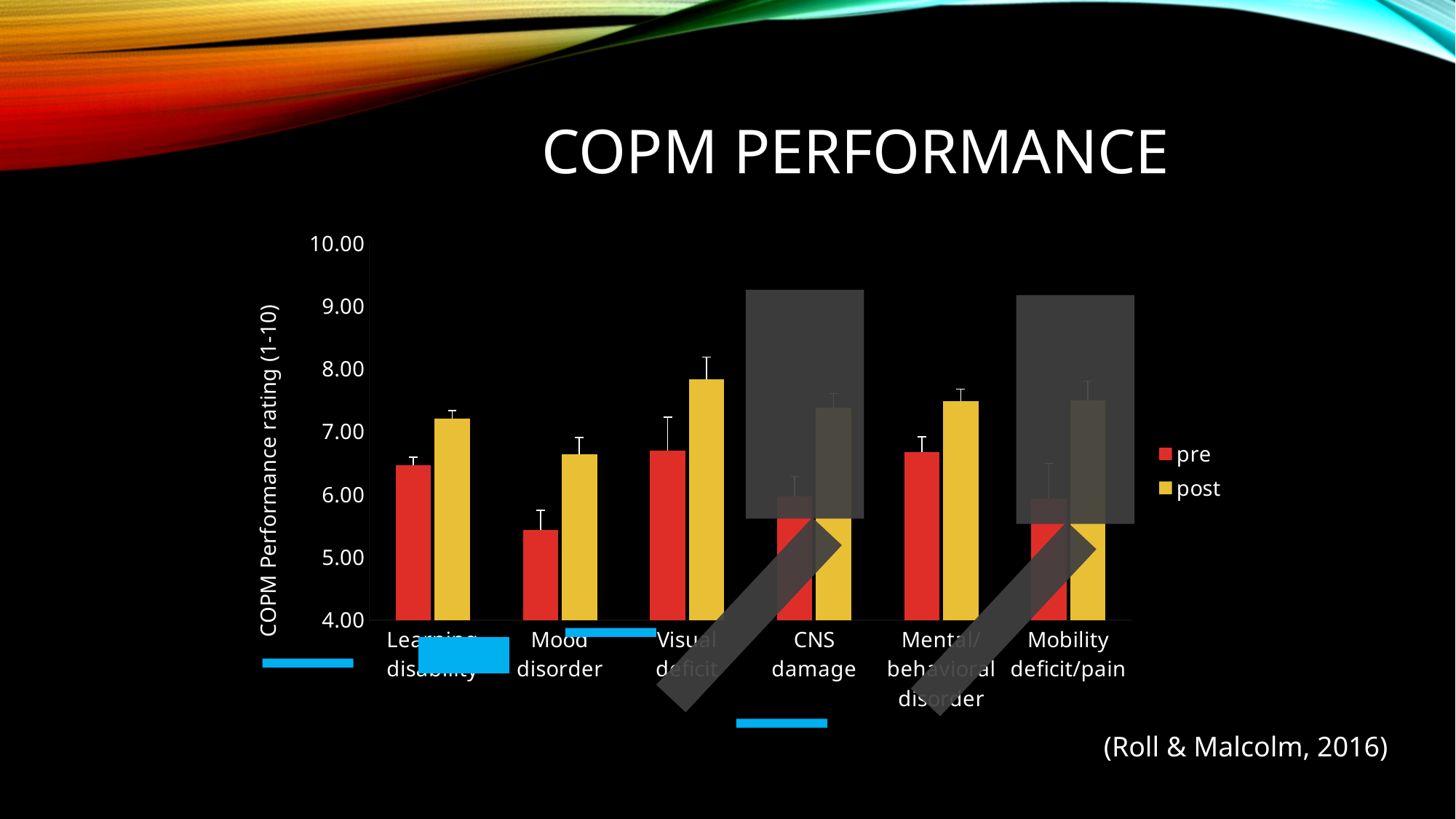
Which is larger, the post value for Visual deficit or the post value for Mood disorder? Visual deficit Is the post value for Mood disorder greater or less than 7.00? less Which category has the lowest pre value? Mood disorder How many categories are shown on the x axis? 6 Which category has the highest post value? Visual deficit What kind of chart is shown on the slide? bar chart Is the post value for Visual deficit greater or less than 7.00? greater What are the two series named in the legend? pre and post Is the pre value for Mood disorder greater or less than 6.00? less Which is larger for Mood disorder, the pre value or the post value? post What is the label on the vertical axis? COPM Performance rating (1-10) How many series does the legend list? 2